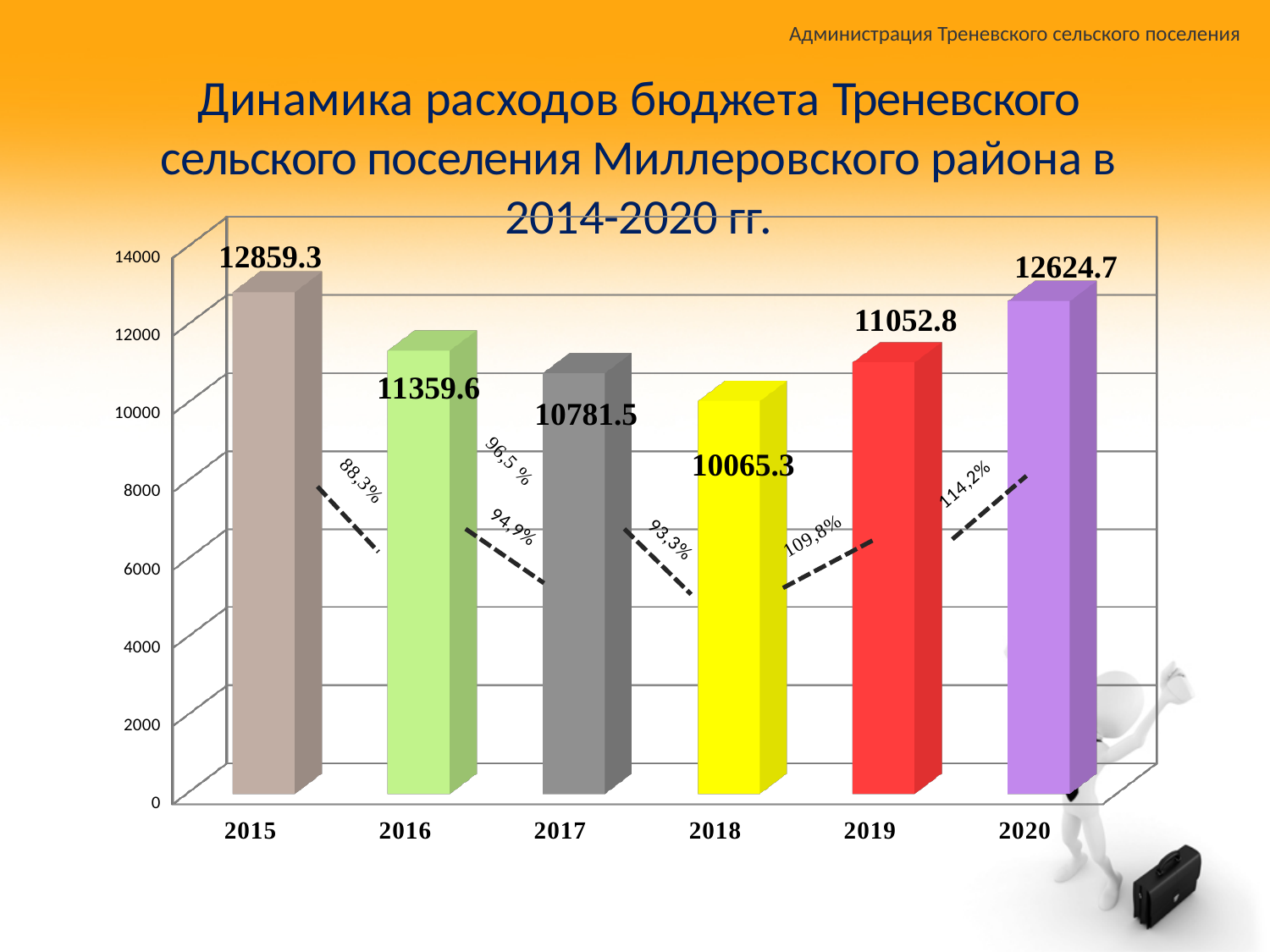
What kind of chart is shown on the slide? bar chart Do the values rise or fall from 2015 to 2018? fall Which year has the highest value? 2015 What is the value for 2020? 12624.7 Is the value for 2017 greater or less than 12000? less What is the value for 2018? 10065.3 Which year has the lowest value? 2018 What is the value for 2015? 12859.3 How many years are shown on the x axis? 6 What is the difference between the values for 2015 and 2020? 234.6 Which is larger, the value for 2016 or the value for 2019? 2016 What is the difference between the values for 2019 and 2018? 987.5